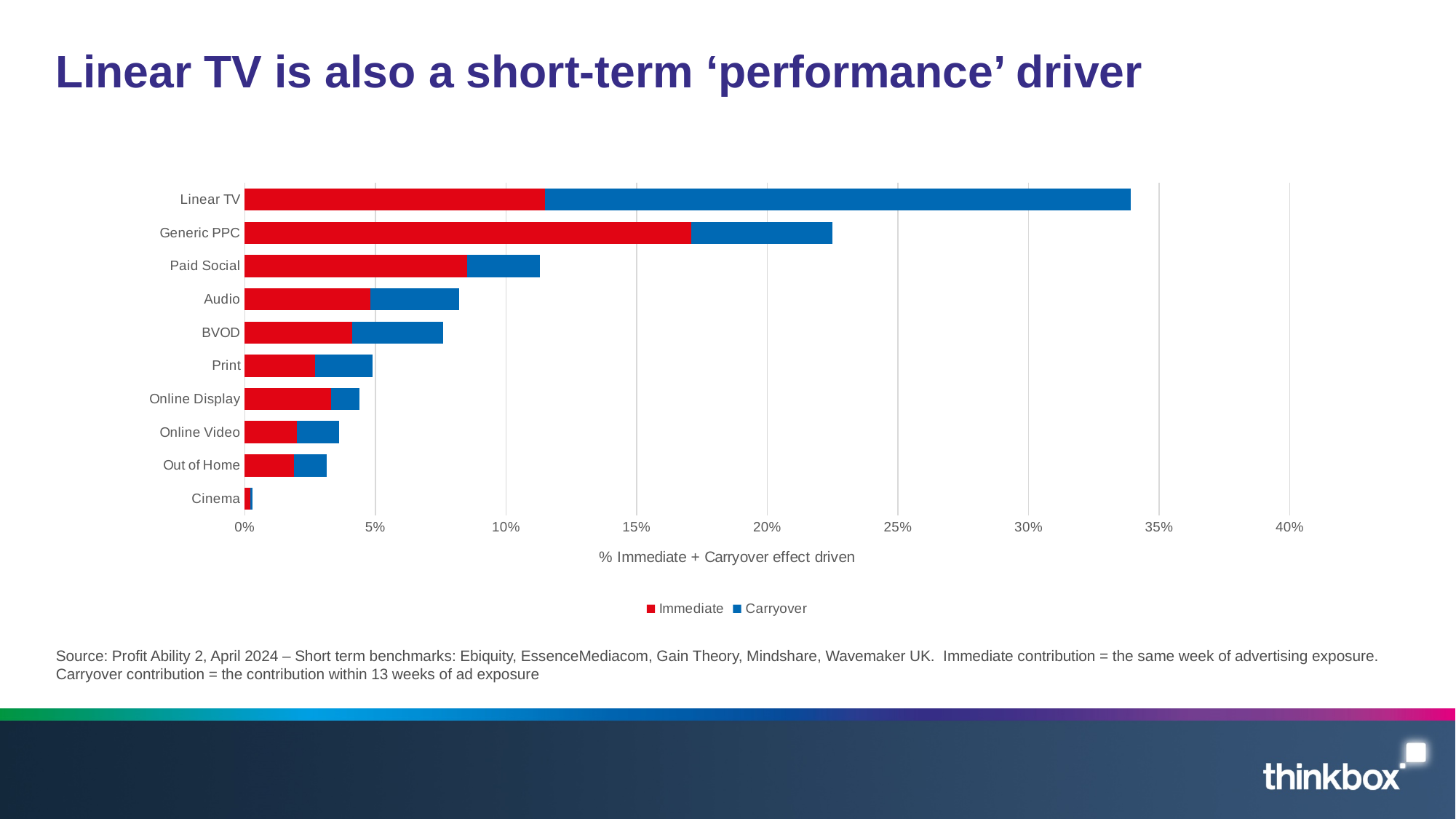
Is the total value for Online Display greater or less than 5%? less How many series does the legend list? 2 Which has the larger Immediate contribution, Generic PPC or Linear TV? Generic PPC Is the total value for Generic PPC greater or less than 25%? less Is the total value for Linear TV greater or less than 30%? greater Which channel has the highest total % Immediate + Carryover effect driven? Linear TV What kind of chart is shown on the slide? bar chart Which channel has the lowest total % Immediate + Carryover effect driven? Cinema Which has the larger total bar, Paid Social or Audio? Paid Social What is the title of the horizontal axis? % Immediate + Carryover effect driven How many media channels are listed on the chart? 10